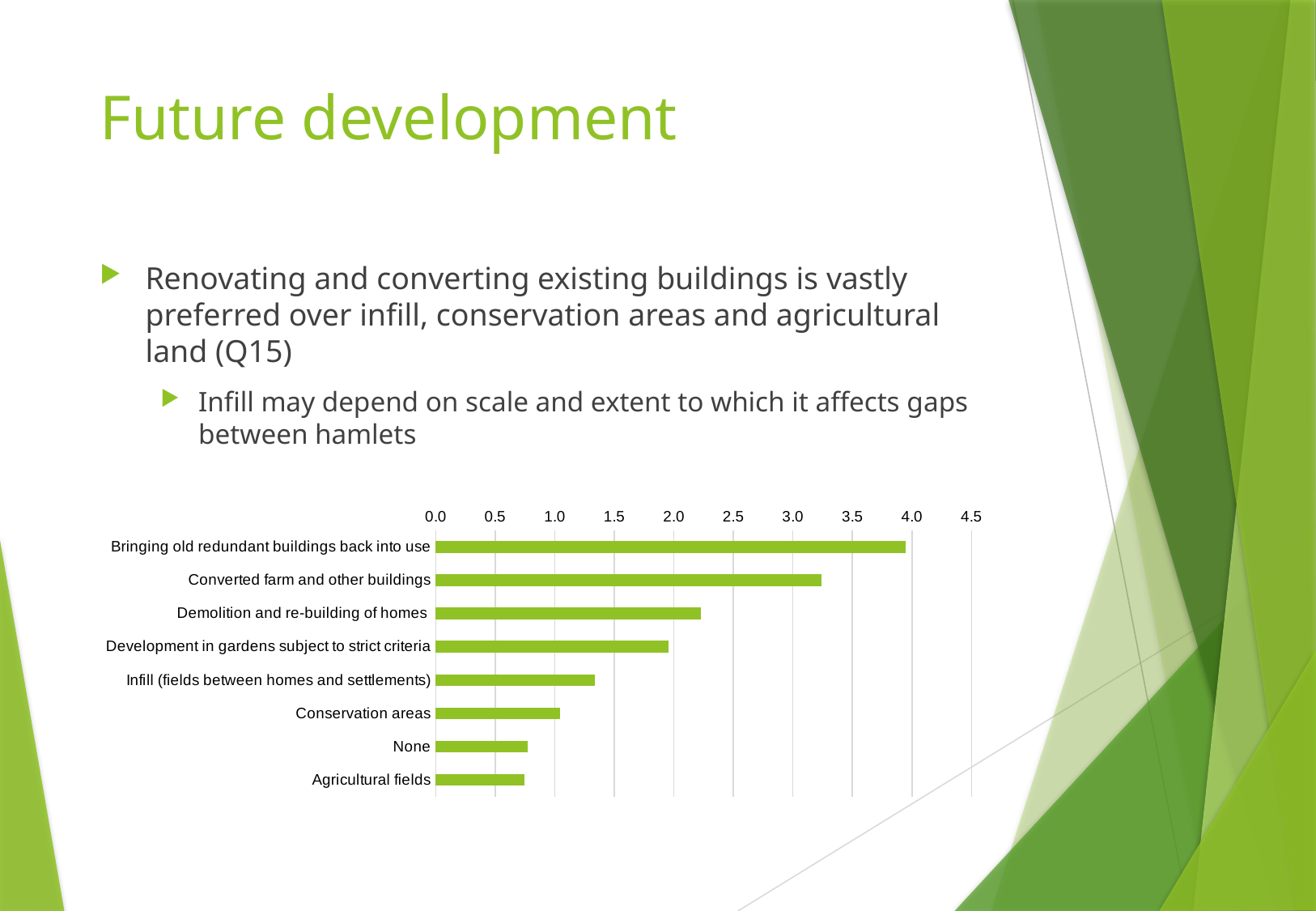
Which is larger, the value for Conservation areas or the value for Infill (fields between homes and settlements)? Infill (fields between homes and settlements) How many categories are plotted in the bar chart? 8 What kind of chart is shown on the slide? bar chart Which is larger, the value for Converted farm and other buildings or the value for Demolition and re-building of homes? Converted farm and other buildings Is the value for Demolition and re-building of homes greater or less than 2.0? greater Is the value for Agricultural fields greater or less than 1.0? less Is the value for Infill (fields between homes and settlements) greater or less than 1.5? less Which category has the highest value in the bar chart? Bringing old redundant buildings back into use What colour are the bars in the chart? green What is the highest value shown on the chart's axis? 4.5